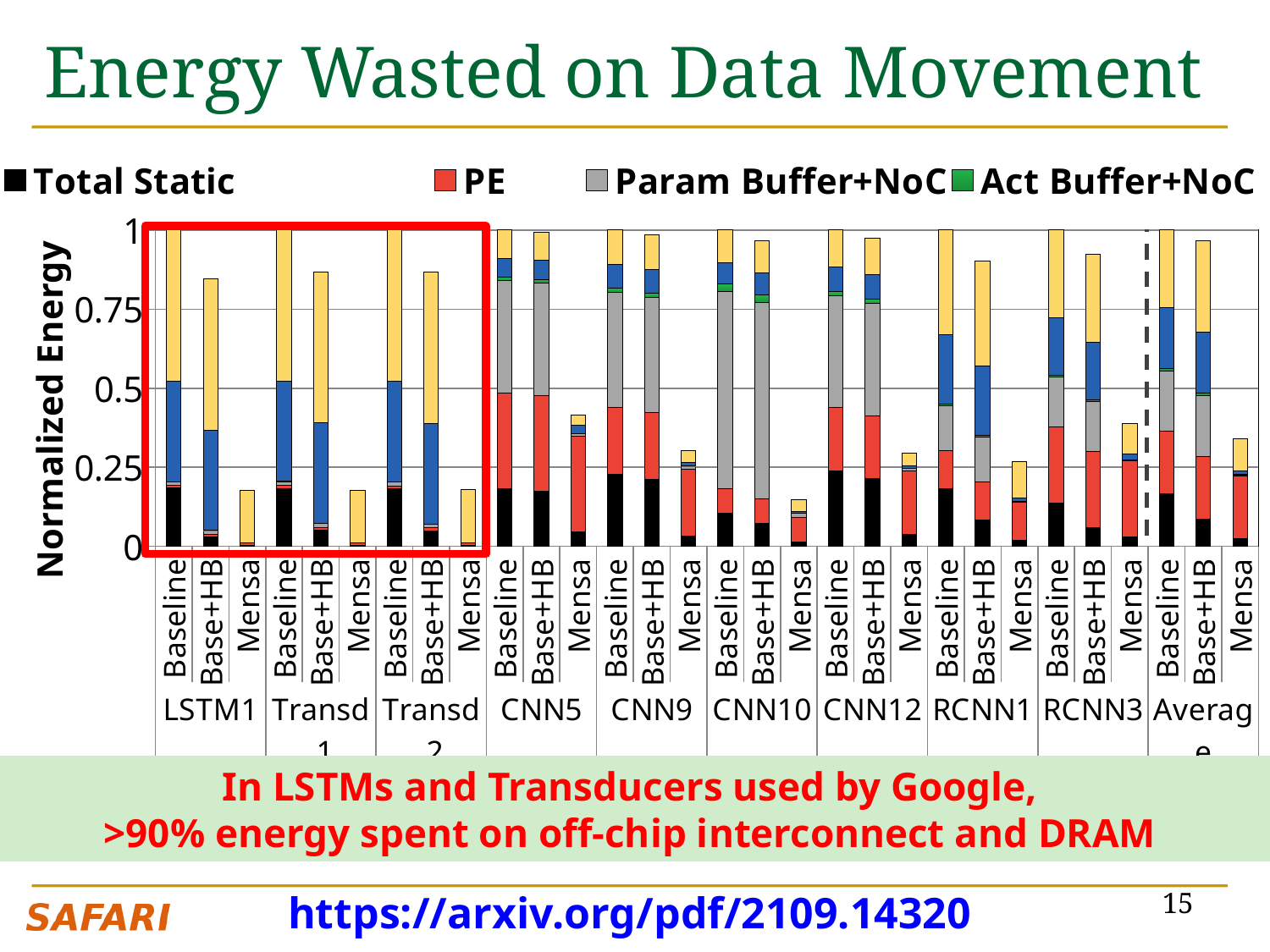
How many bars are shown within each workload group? 3 Is the total value of the Mensa bar for Average greater or less than 0.5? less What is the label on the y-axis of the chart? Normalized Energy Within the Average group, which of the three bars has the lowest total? Mensa How many series does the chart's legend list? 4 Within the LSTM1 group, which bar is larger in total: Baseline or Mensa? Baseline How many workload groups (e.g., LSTM1, CNN5) are shown along the x-axis, including Average? 10 Is the total value of the Mensa bar for CNN5 greater or less than 0.25? greater What kind of chart is shown on the slide? Stacked bar chart Is the total value of the Base+HB bar for RCNN1 greater or less than 0.75? greater What is the title of the slide containing the chart? Energy Wasted on Data Movement